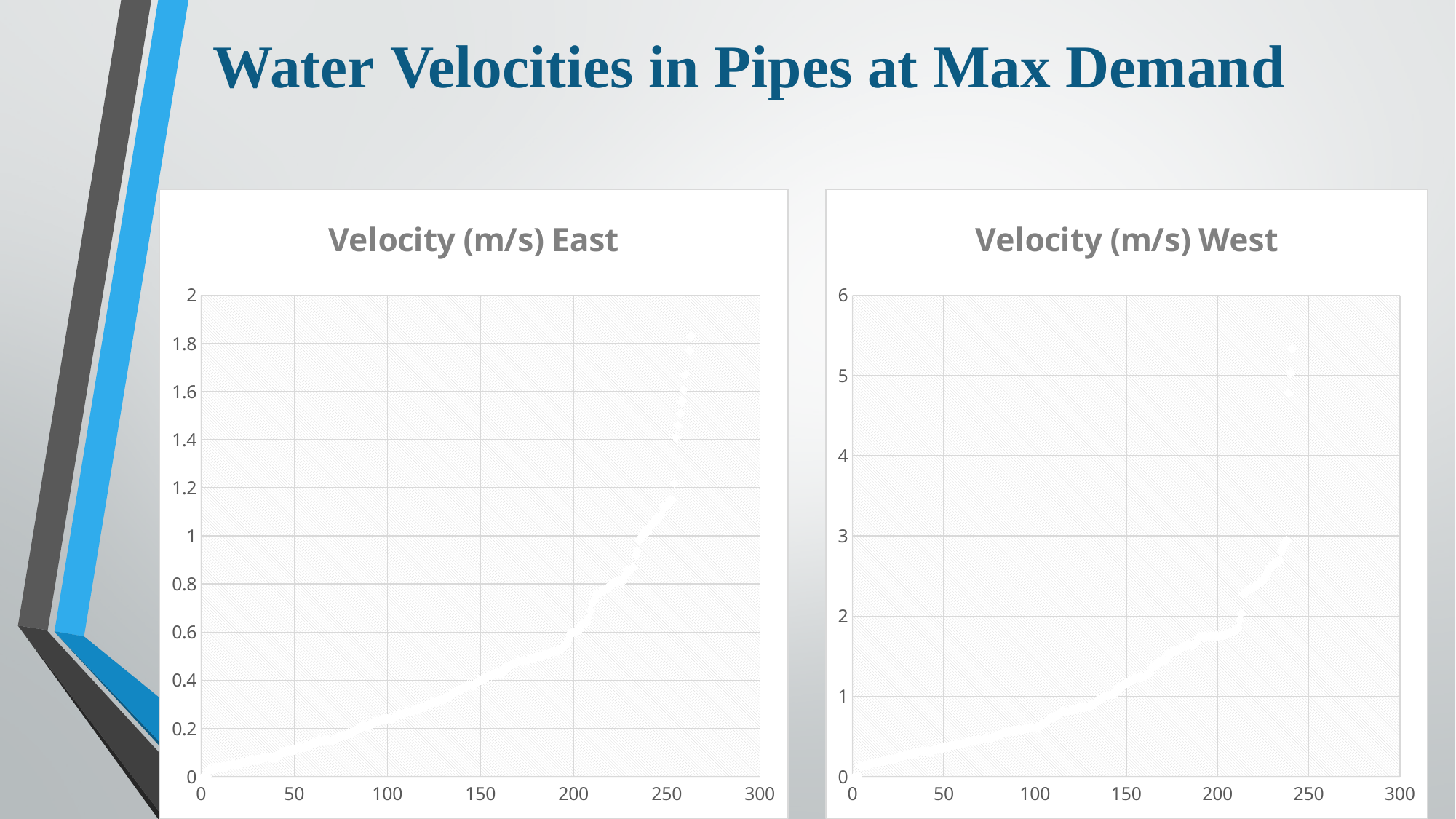
In the "Velocity (m/s) East" chart, is the value at x = 200 greater or less than 0.4? greater How many charts are shown on the slide? 2 What kind of chart is the "Velocity (m/s) West" chart? scatter chart In the "Velocity (m/s) West" chart, is the value at x = 100 greater or less than 1? less In the "Velocity (m/s) East" chart, do the values rise or fall as the x axis increases? rise What is the maximum value shown on the y axis of the "Velocity (m/s) East" chart? 2 In the "Velocity (m/s) West" chart, is the highest plotted value greater or less than 4? greater What is the maximum value shown on the y axis of the "Velocity (m/s) West" chart? 6 What kind of chart is the "Velocity (m/s) East" chart? scatter chart In the "Velocity (m/s) West" chart, do the values rise or fall as the x axis increases? rise